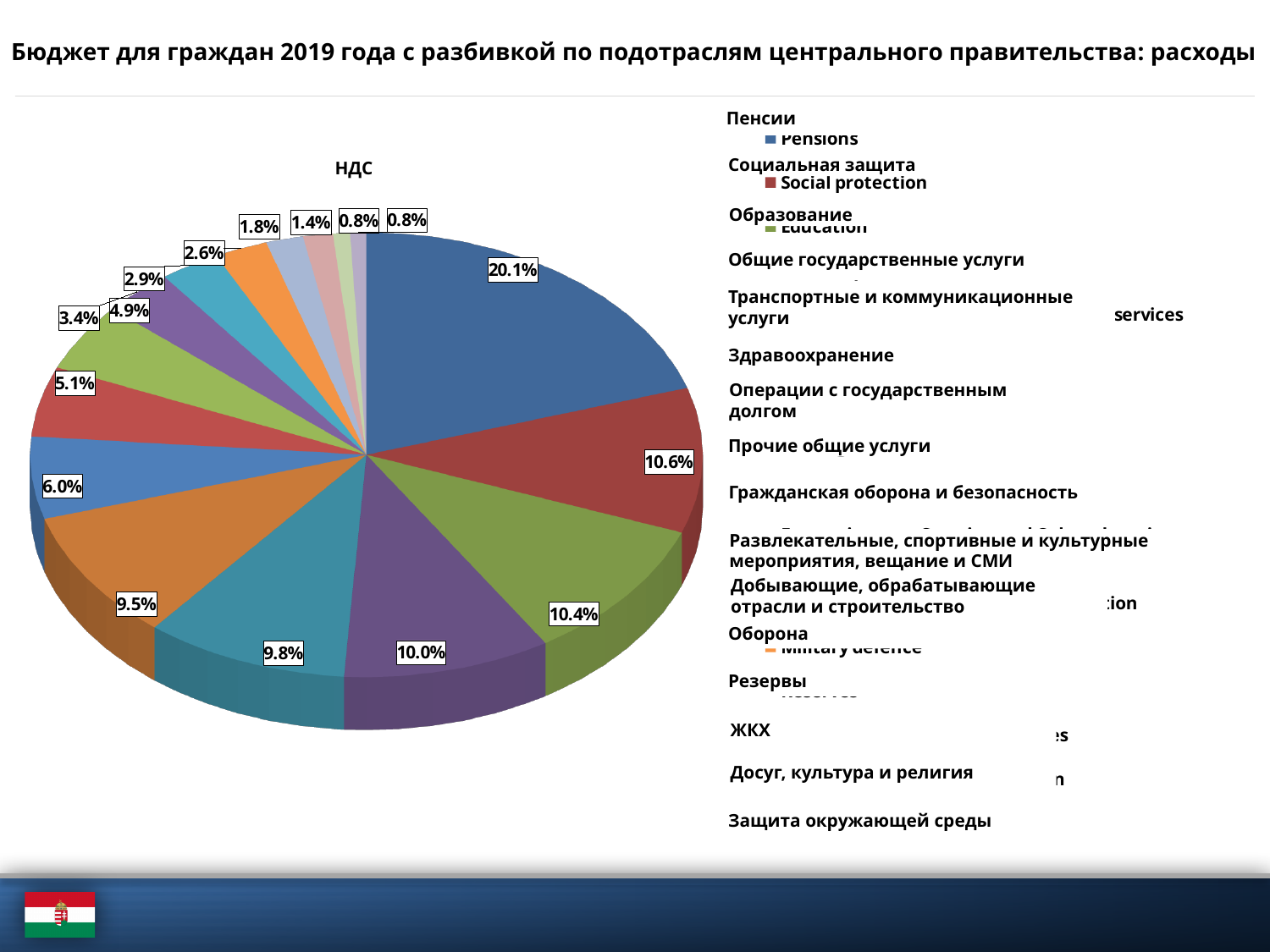
What is the difference between the Pensions slice and the Social protection slice? 9.5% What is the title printed above the pie chart? НДС What is the combined share of the Pensions, Social protection and Education slices? 41.1% What share does the Social protection (Социальная защита) slice have? 10.6% What is the smallest slice value shown on the pie chart? 0.8% What is the largest slice value shown on the pie chart? 20.1% What share does the Education (Образование) slice have? 10.4% What share does the Pensions (Пенсии) slice have? 20.1% How many categories does the legend list? 16 What kind of chart is shown on the slide? pie chart Which is larger, the Social protection slice or the Education slice? Social protection How many slices does the pie chart have? 16